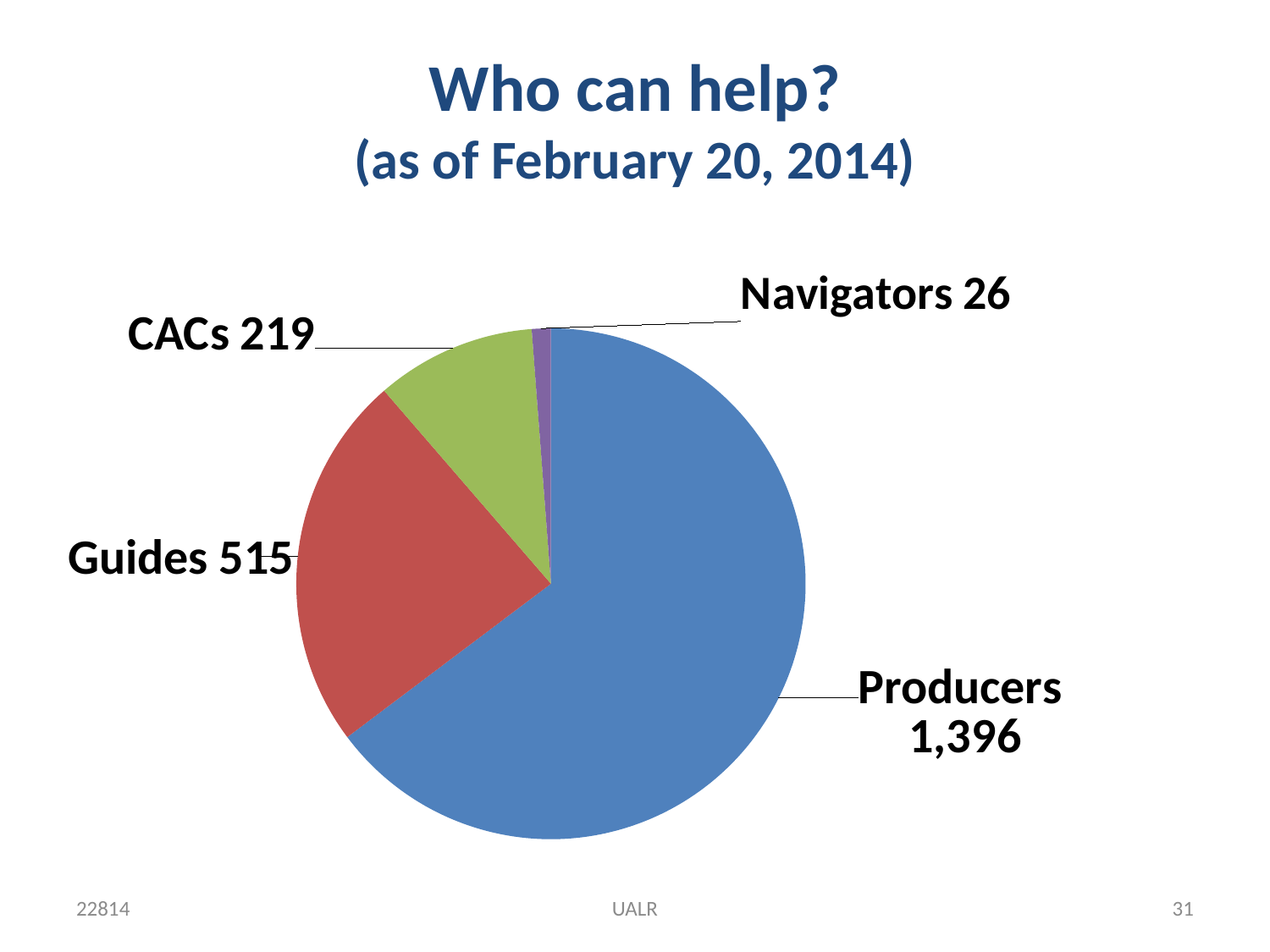
What is the title of the chart on the slide? Who can help? (as of February 20, 2014) Which category has the smallest slice of the pie? Navigators What is the difference between the values for Guides and CACs? 296 Which category has the largest slice of the pie? Producers Which is larger, the value for CACs or the value for Navigators? CACs How many categories are shown in the pie chart? 4 What is the value for Navigators? 26 What is the value for CACs? 219 What is the difference between the values for Producers and Guides? 881 What is the value for Producers? 1,396 What is the value for Guides? 515 What type of chart is shown on the slide? Pie chart